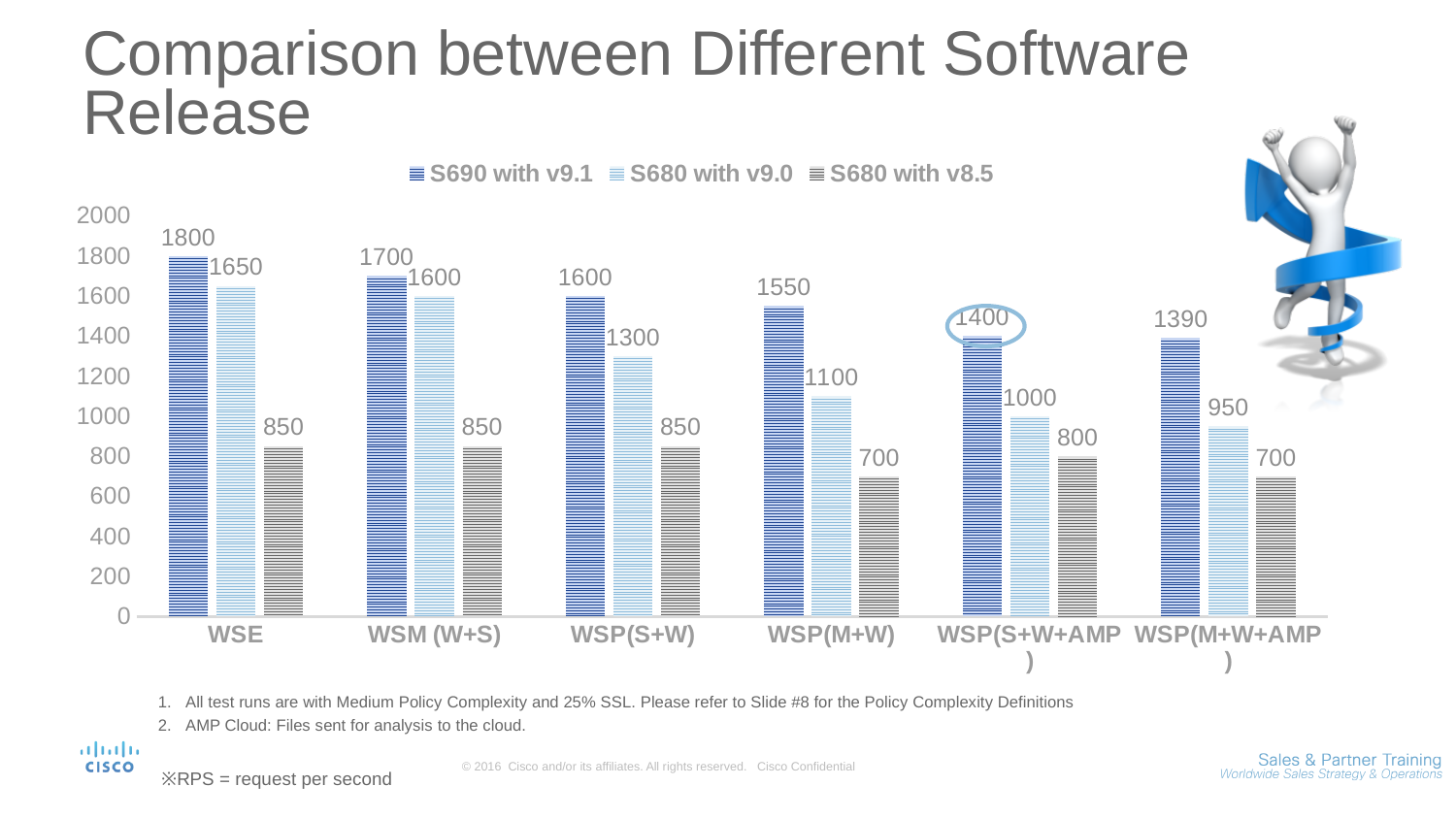
What is the difference between the S690 with v9.1 and S680 with v9.0 values in the WSP(M+W) category? 450 Which category has the highest value for S690 with v9.1? WSE What is the value for S690 with v9.1 in the WSE category? 1800 Which is larger: the S680 with v8.5 value for WSP(S+W+AMP) or for WSP(M+W+AMP)? WSP(S+W+AMP) Do the S690 with v9.1 values rise or fall from WSE to WSP(M+W+AMP)? fall How many categories are shown on the x axis? 6 What is the value for S680 with v9.0 in the WSP(S+W) category? 1300 How many series does the legend list? 3 Is the value for S680 with v9.0 in the WSM (W+S) category greater or less than 1400? greater What kind of chart is shown on the slide? bar chart Which category has the lowest value for S680 with v9.0? WSP(M+W+AMP) What is the value for S680 with v8.5 in the WSP(S+W+AMP) category? 800